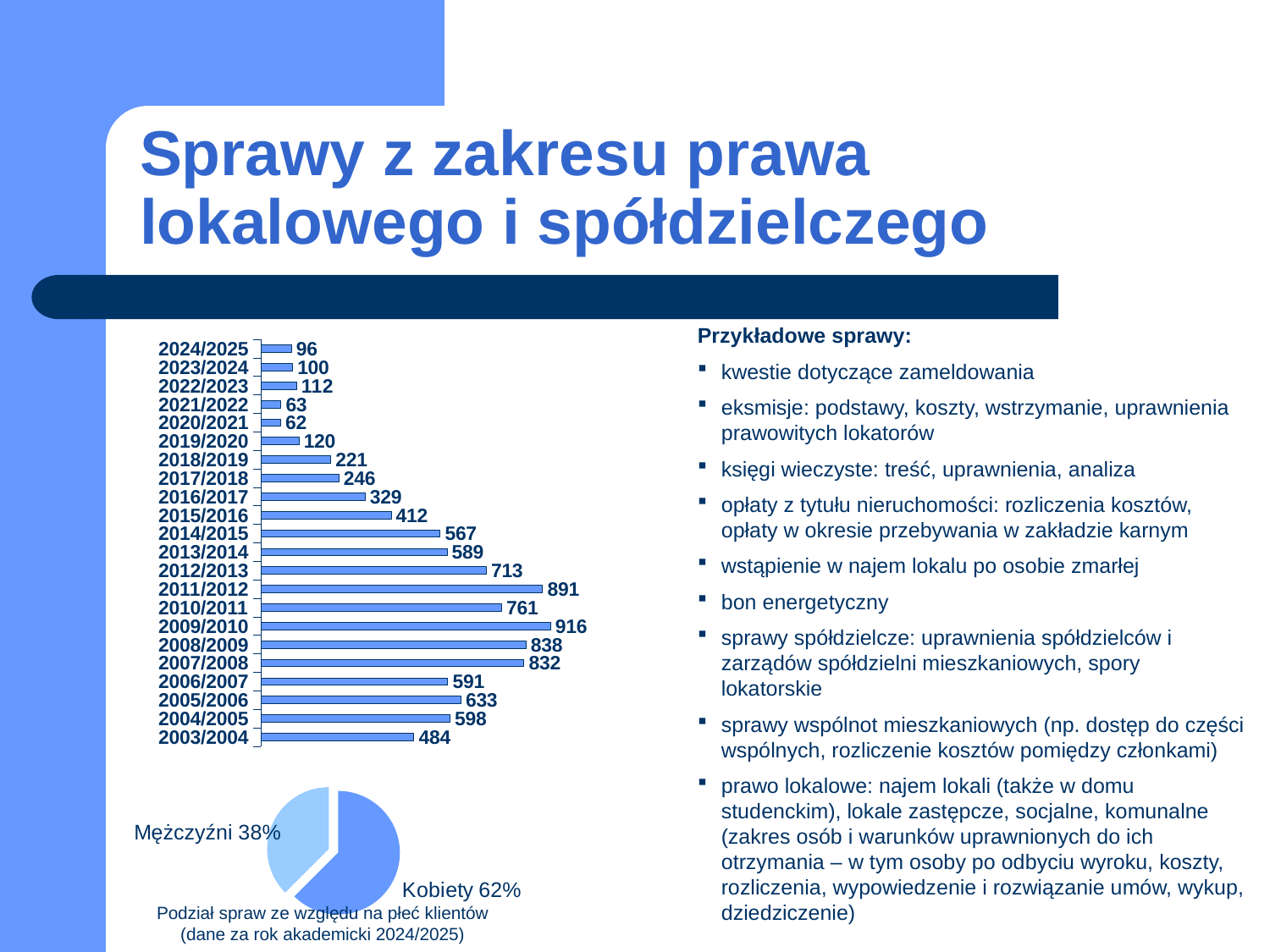
In the pie chart at the bottom left, what share is labelled Kobiety? 62% What kind of chart is the chart at the bottom left of the slide? pie chart In the bar chart on the left, what is the value for 2024/2025? 96 In the bar chart on the left, which year has the lowest value? 2020/2021 In the bar chart on the left, what is the value for 2015/2016? 412 In the bar chart on the left, what is the difference between the values for 2011/2012 and 2010/2011? 130 What kind of chart is the chart at the top left of the slide? bar chart How many years (categories) are shown in the bar chart on the left? 22 In the bar chart on the left, which is larger, the value for 2005/2006 or the value for 2004/2005? 2005/2006 In the pie chart at the bottom left, what share is labelled Mężczyźni? 38% In the bar chart on the left, what is the value for 2009/2010? 916 In the bar chart on the left, which year has the highest value? 2009/2010